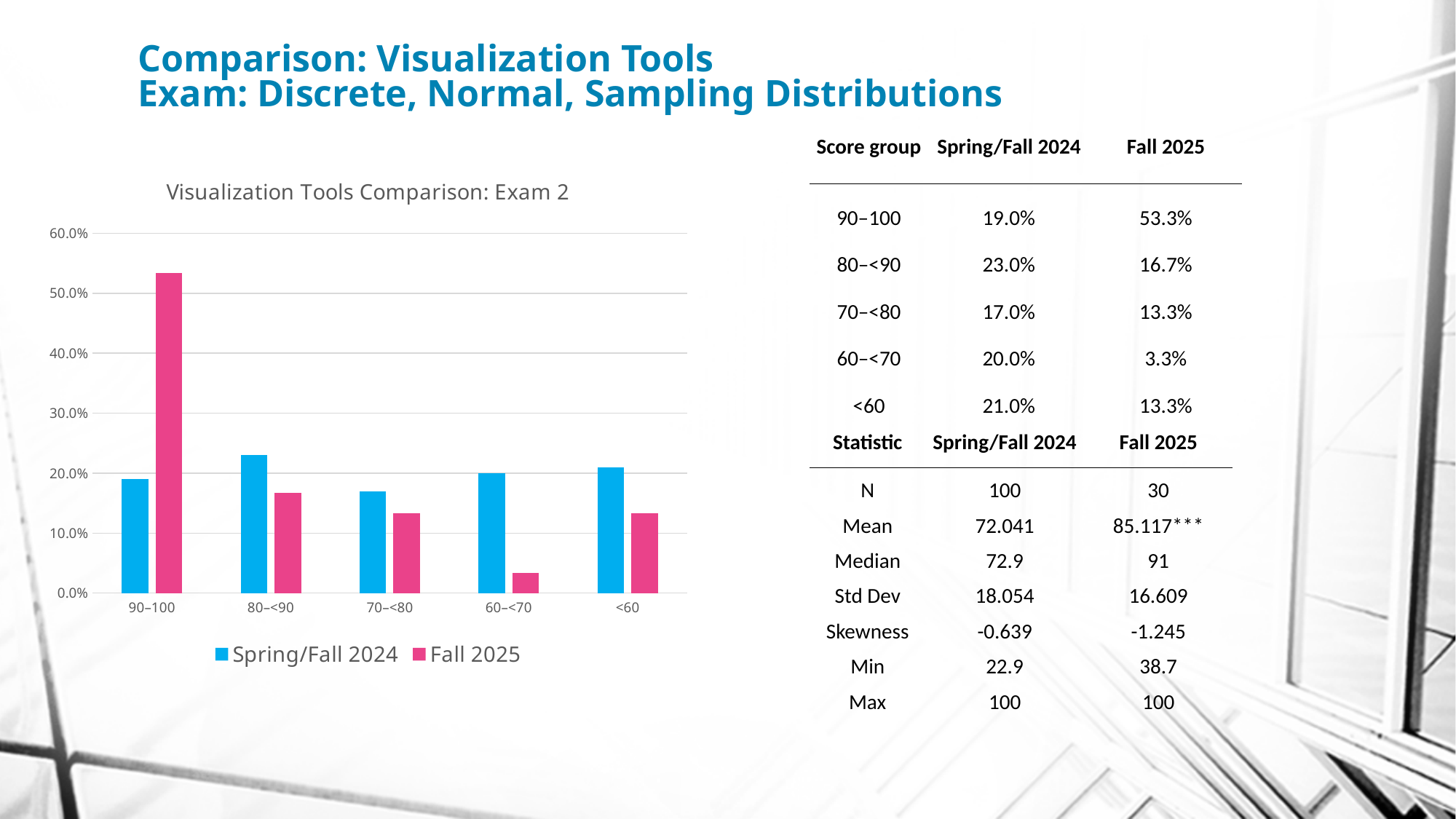
How many series does the chart's legend list? 2 For the 90–100 score group, which series has the larger value, Spring/Fall 2024 or Fall 2025? Fall 2025 Which score group has the highest Fall 2025 bar? 90–100 Is the Fall 2025 value for the 90–100 score group greater or less than 50.0%? greater What kind of chart is shown on the slide? bar chart What is the title of the chart? Visualization Tools Comparison: Exam 2 Which score group has the lowest Fall 2025 bar? 60–<70 Is the Spring/Fall 2024 value for the 80–<90 score group greater or less than 20.0%? greater What is the Spring/Fall 2024 value for the 90–100 score group? 19.0% What is the Fall 2025 value for the 60–<70 score group? 3.3% How many score-group categories are shown on the x axis of the chart? 5 For the 60–<70 score group, which series has the larger value, Spring/Fall 2024 or Fall 2025? Spring/Fall 2024